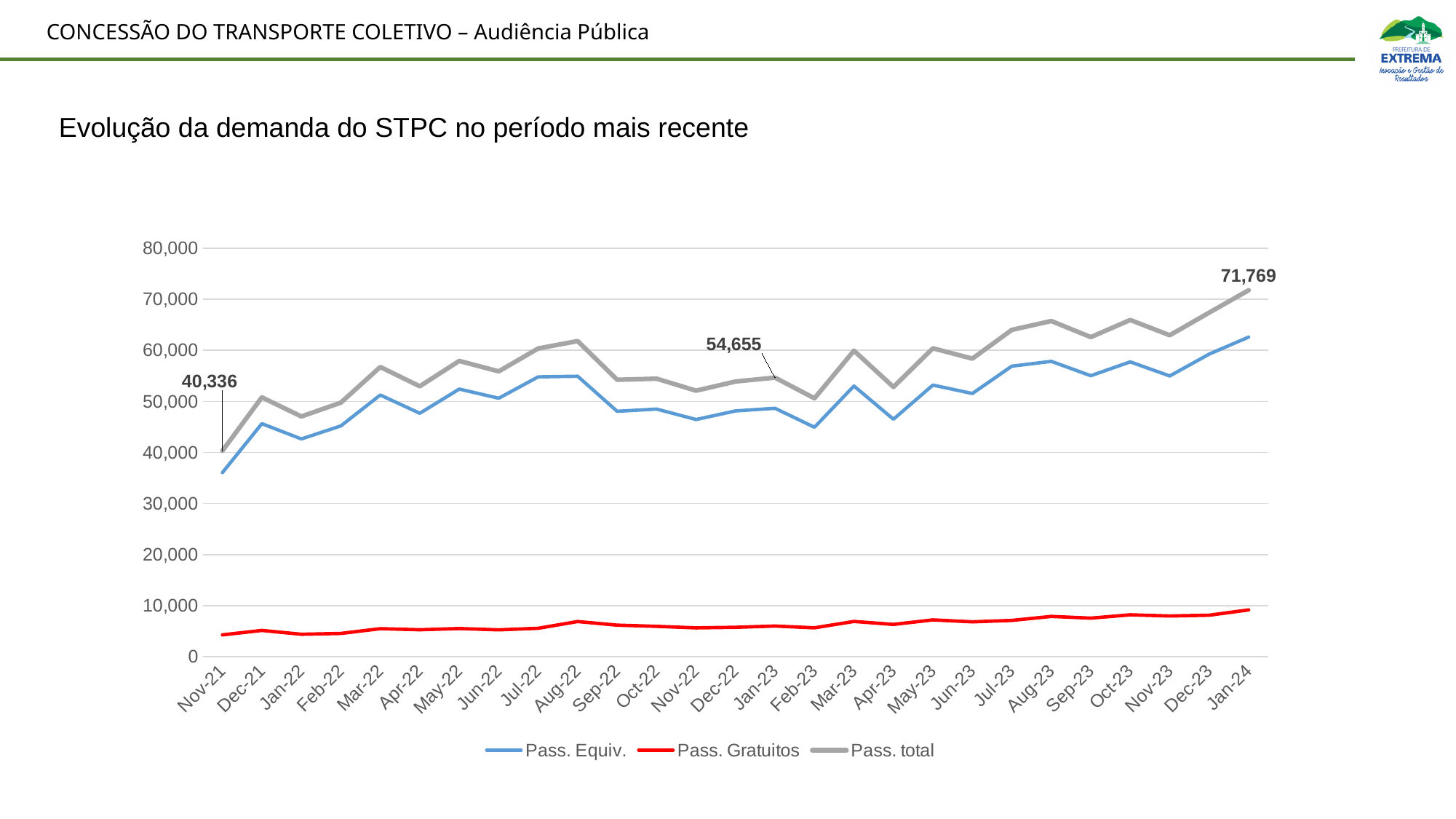
What is the value of Pass. total in Jan-23? 54,655 How many series does the legend list? 3 What is the value of Pass. total in Nov-21? 40,336 What is the difference between the Pass. total values in Jan-24 and Jan-23? 17,114 In which month is Pass. total highest? Jan-24 Which series is shown in red in the legend? Pass. Gratuitos Is the value for Pass. Gratuitos in Jan-24 greater or less than 10,000? less In which month is Pass. total lowest? Nov-21 What type of chart is shown on the slide? line chart What is the difference between the Pass. total values in Jan-24 and Nov-21? 31,433 What is the value of Pass. total in Jan-24? 71,769 How many months are plotted along the x axis? 27